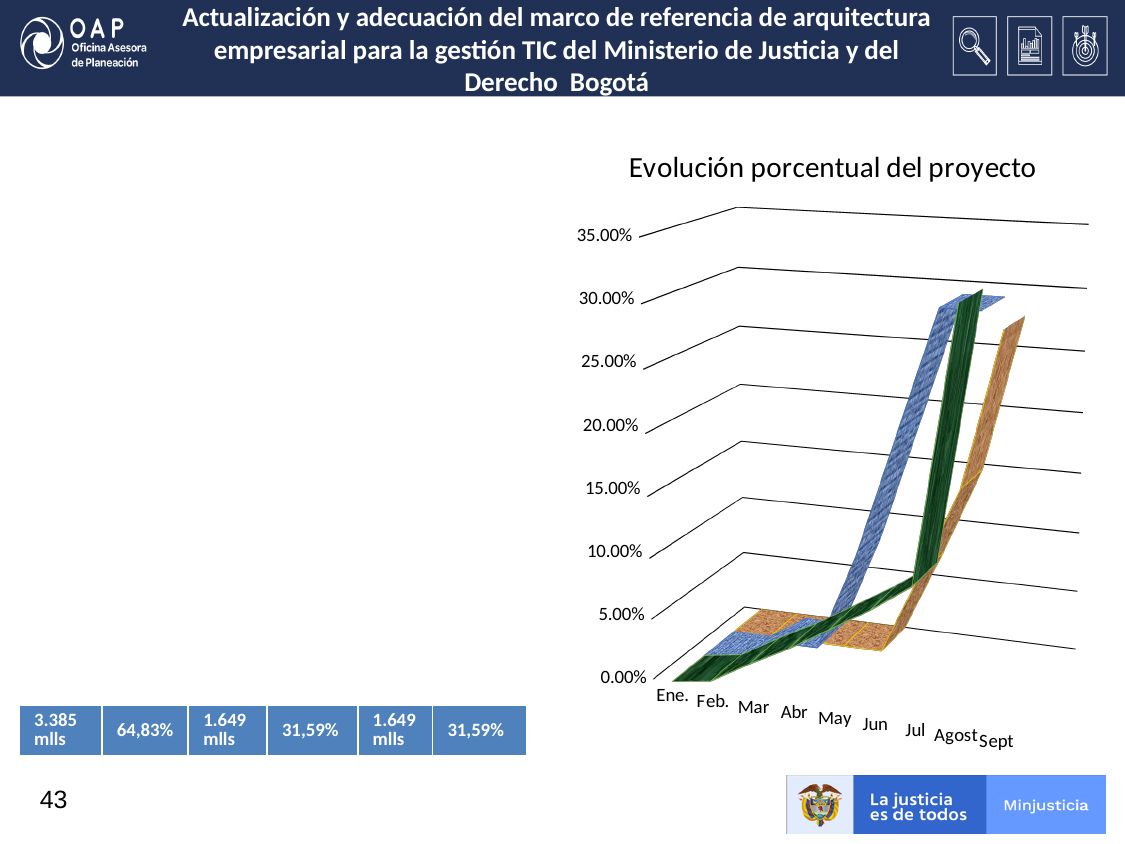
How many months are shown on the x axis of the chart? 9 Which month has the lowest values in the chart? Ene. How many coloured lines (series) are plotted in the chart? 3 What is the title of the chart on the slide? Evolución porcentual del proyecto What kind of chart is 'Evolución porcentual del proyecto'? line chart Is the value for Ene. greater or less than 5.00%? less Which month has the highest values in the chart? Agost Is the value for Mar greater or less than 10.00%? less Do the values in the chart rise or fall from Ene. to Sept? rise What is the highest tick value shown on the vertical axis of the chart? 35.00%